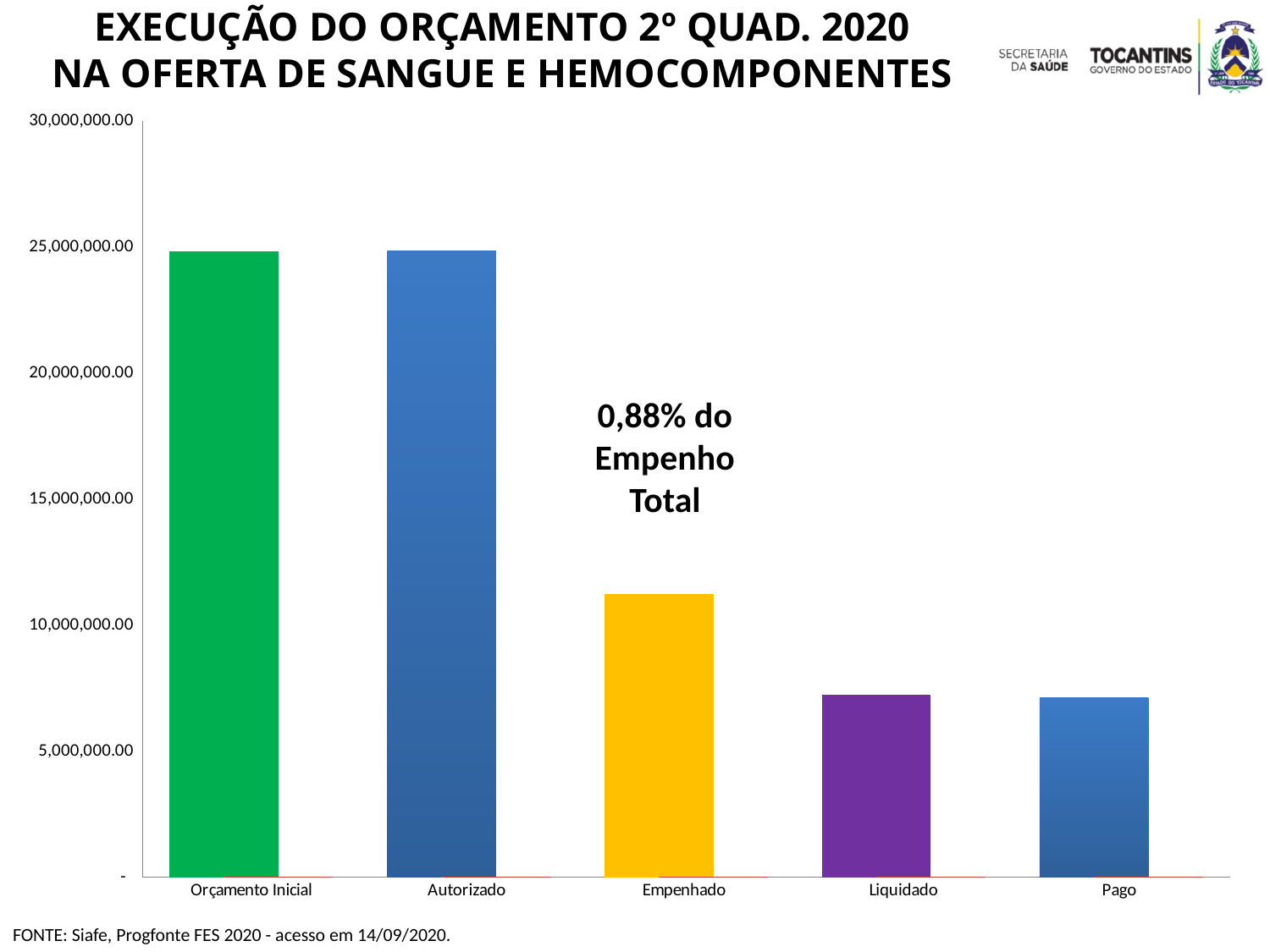
What kind of chart is shown on the slide? bar chart Which is larger, the value for Autorizado or the value for Pago? Autorizado How many categories are shown on the x axis of the chart? 5 Which is larger, the value for Empenhado or the value for Liquidado? Empenhado Is the value for Empenhado greater or less than 10,000,000.00? greater Do the values generally rise or fall moving from Orçamento Inicial to Pago along the x axis? fall Is the value for Empenhado greater or less than 15,000,000.00? less Is the value for Liquidado greater or less than 5,000,000.00? greater What percentage is stated in the text annotation above the Empenhado bar? 0,88%